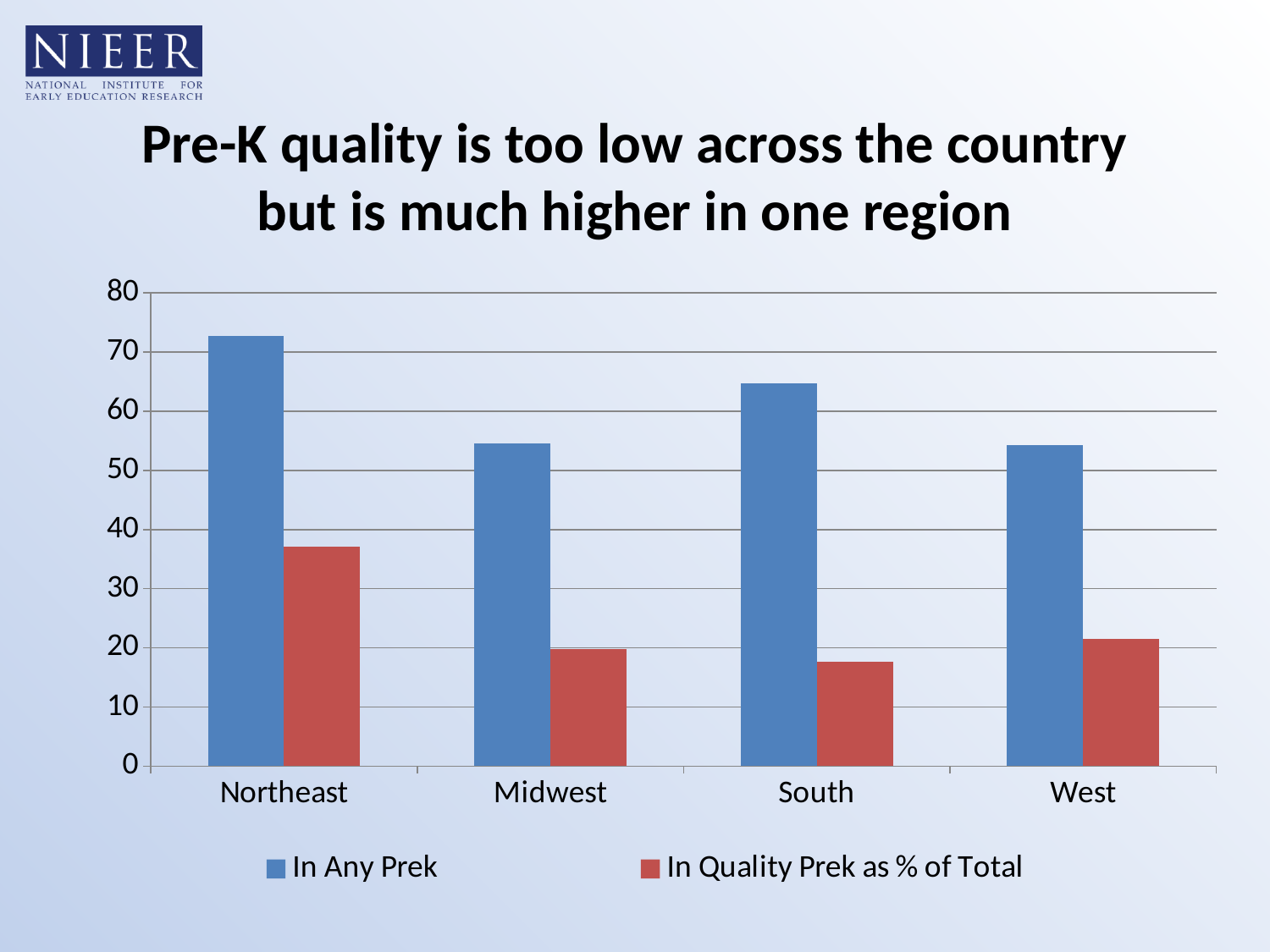
How many regions are shown on the x axis of the chart? 4 Is the In Any Prek value for South greater or less than 60? greater Which region has the lowest value for In Quality Prek as % of Total? South How many series does the chart's legend list? 2 What is the title of the chart on the slide? Pre-K quality is too low across the country but is much higher in one region Is the In Any Prek value for Northeast greater or less than 70? greater Which region has the highest value for In Quality Prek as % of Total? Northeast Is the In Quality Prek as % of Total value for Northeast greater or less than 40? less What kind of chart is shown on the slide? bar chart Which is larger, the In Any Prek value for South or for Midwest? South Which region has the highest value for In Any Prek? Northeast